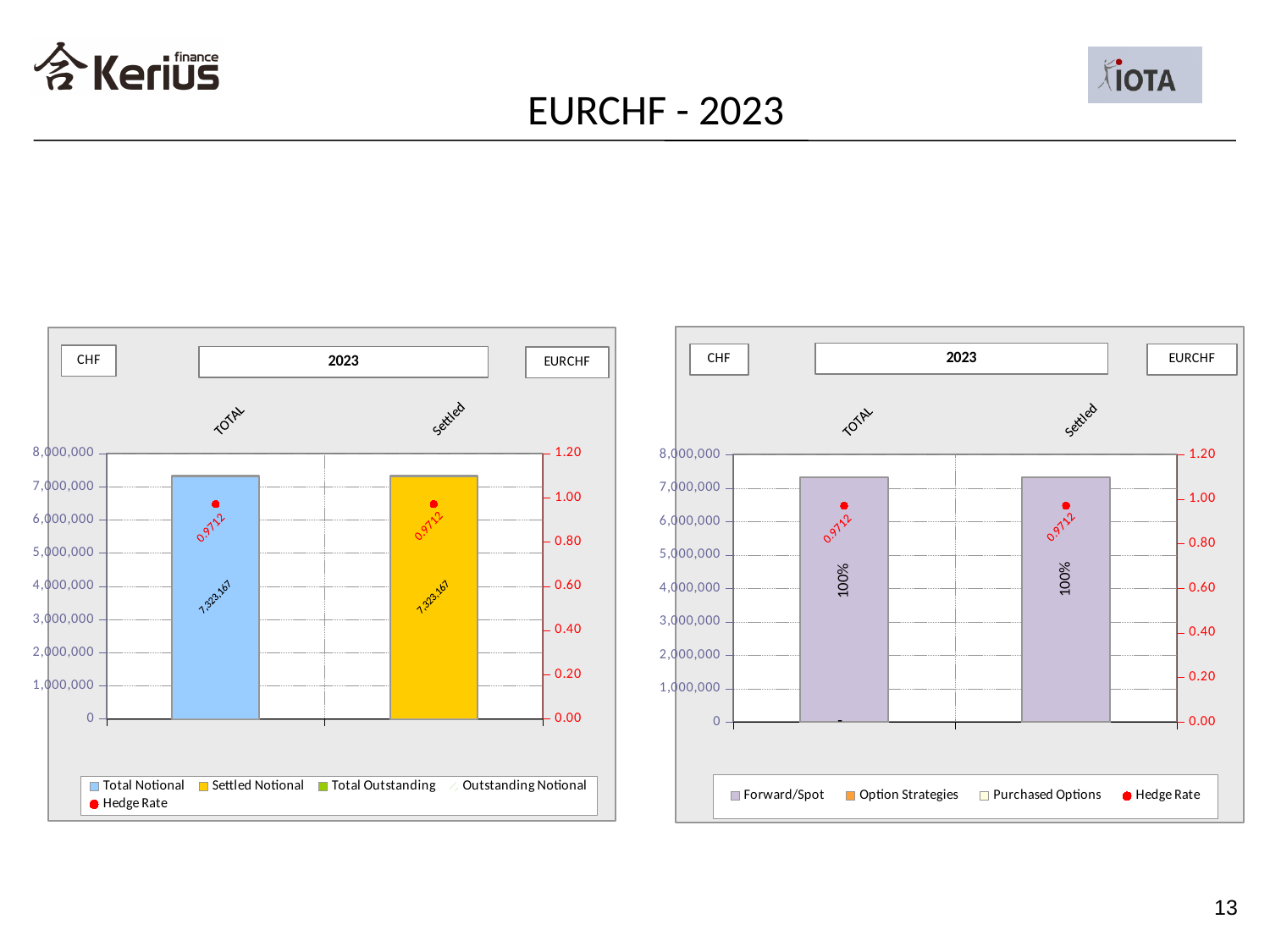
In the left chart, what is the difference between the TOTAL and Settled bar values? 0 How many categories are shown on the x axis of the left chart? 2 In the right chart, is the Hedge Rate for TOTAL greater or less than 1.00? less How many series does the legend of the left chart list? 5 In the right chart, what is the Hedge Rate value shown for Settled? 0.9712 In the left chart, is the TOTAL bar value greater or less than 7,000,000? greater In the right chart, what percentage is printed on the TOTAL bar? 100% In the right chart, what percentage is printed on the Settled bar? 100% In the left chart, what is the Hedge Rate value shown for TOTAL? 0.9712 How many series does the legend of the right chart list? 4 In the left chart, what is the value printed on the Settled bar? 7,323,167 In the left chart, what is the value printed on the TOTAL bar? 7,323,167